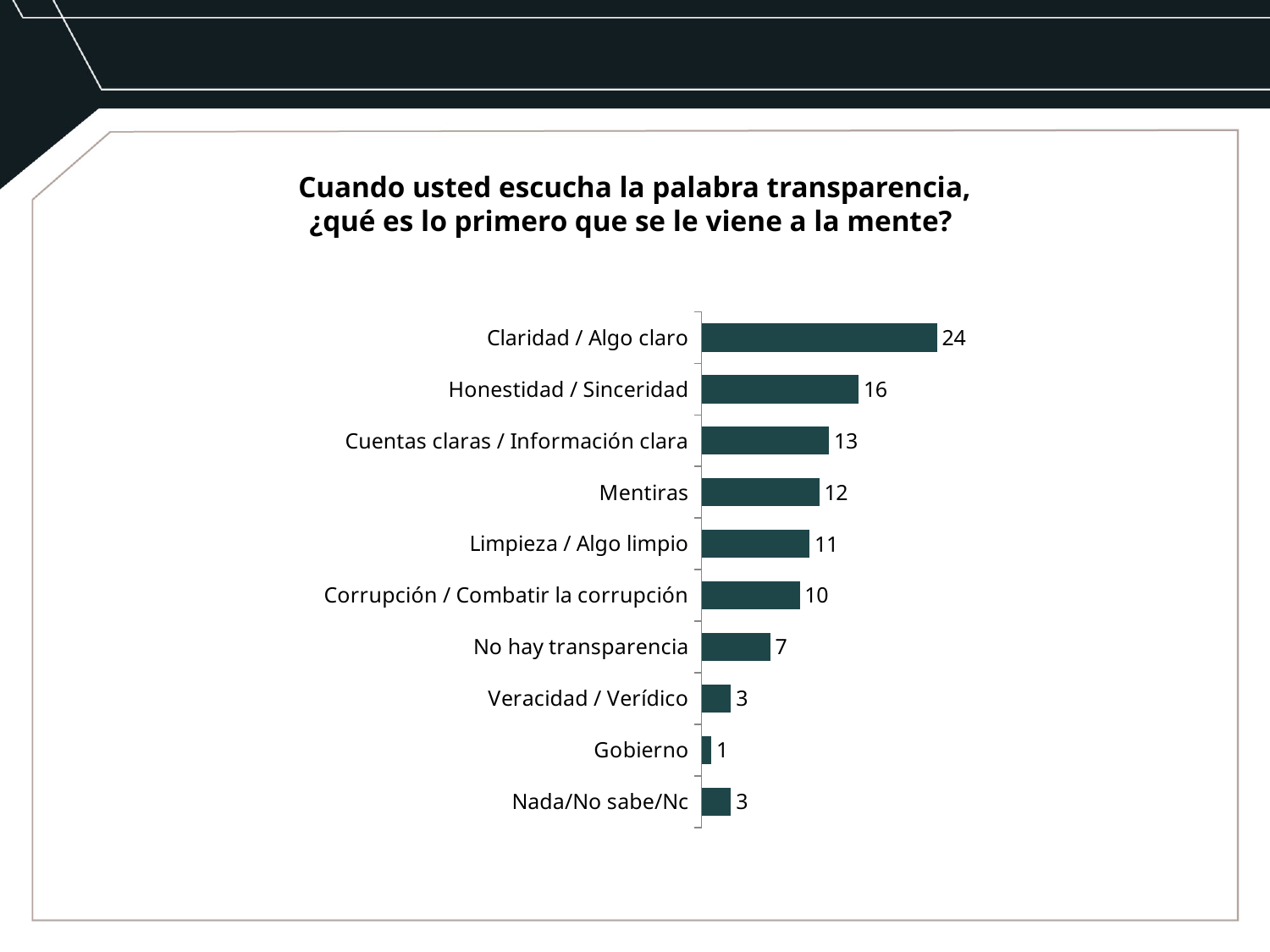
What is the value for Mentiras? 12 What is the difference between the values for Claridad / Algo claro and Honestidad / Sinceridad? 8 What is the title of the chart? Cuando usted escucha la palabra transparencia, ¿qué es lo primero que se le viene a la mente? How many categories are shown in the chart? 10 What is the value for Claridad / Algo claro? 24 What is the value for Gobierno? 1 Which is larger, the value for Limpieza / Algo limpio or the value for Corrupción / Combatir la corrupción? Limpieza / Algo limpio Which category has the highest value? Claridad / Algo claro What is the value for No hay transparencia? 7 Which category has the lowest value? Gobierno What kind of chart is shown on the slide? Bar chart What is the difference between the values for Cuentas claras / Información clara and Veracidad / Verídico? 10